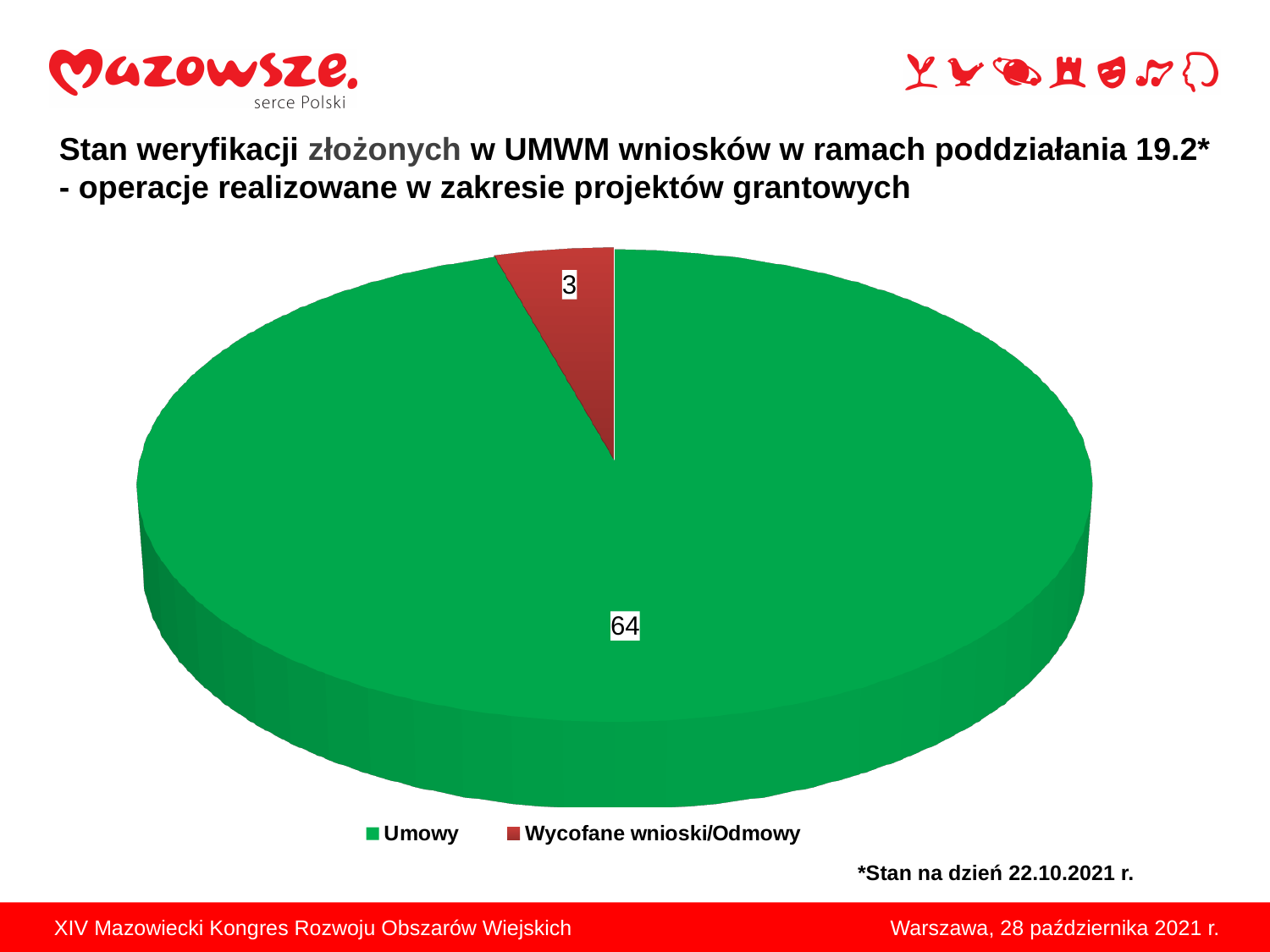
What is the total of all slices in the pie chart? 67 What is the value for Umowy in the pie chart? 64 What colour is the Umowy slice in the pie chart? Green Which category has the smallest slice in the pie chart? Wycofane wnioski/Odmowy What kind of chart is shown on the slide? Pie chart How many entries does the legend list? 2 Which category has the largest slice in the pie chart? Umowy Which is larger, the value for Umowy or the value for Wycofane wnioski/Odmowy? Umowy What is the difference between the values for Umowy and Wycofane wnioski/Odmowy? 61 What colour is the Wycofane wnioski/Odmowy slice in the pie chart? Red What is the value for Wycofane wnioski/Odmowy in the pie chart? 3 How many slices does the pie chart have? 2